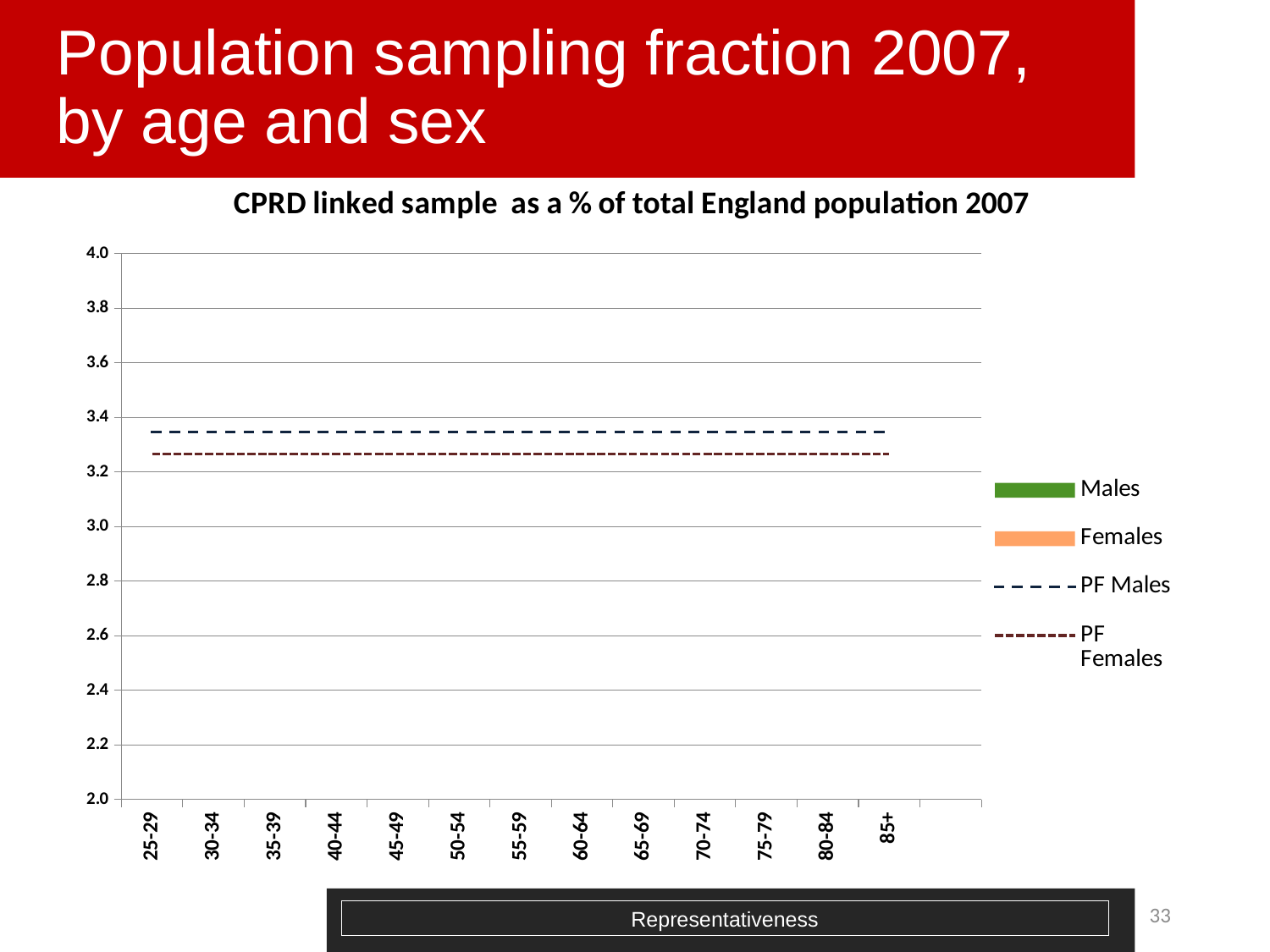
Which series are listed in the legend? Males, Females, PF Males, PF Females What is the first age category on the x axis? 25-29 How many series does the legend list? 4 Does the PF Females line rise, fall or stay flat across the age groups? stays flat Does the PF Males line rise, fall or stay flat across the age groups? stays flat Is the value of the PF Males line greater or less than 3.2? greater What is the title of the chart? CPRD linked sample as a % of total England population 2007 How many age categories are shown on the x axis? 13 Is the value of the PF Females line greater or less than 3.2? greater Is the value of the PF Males line greater or less than 3.4? less Which line is higher, PF Males or PF Females? PF Males